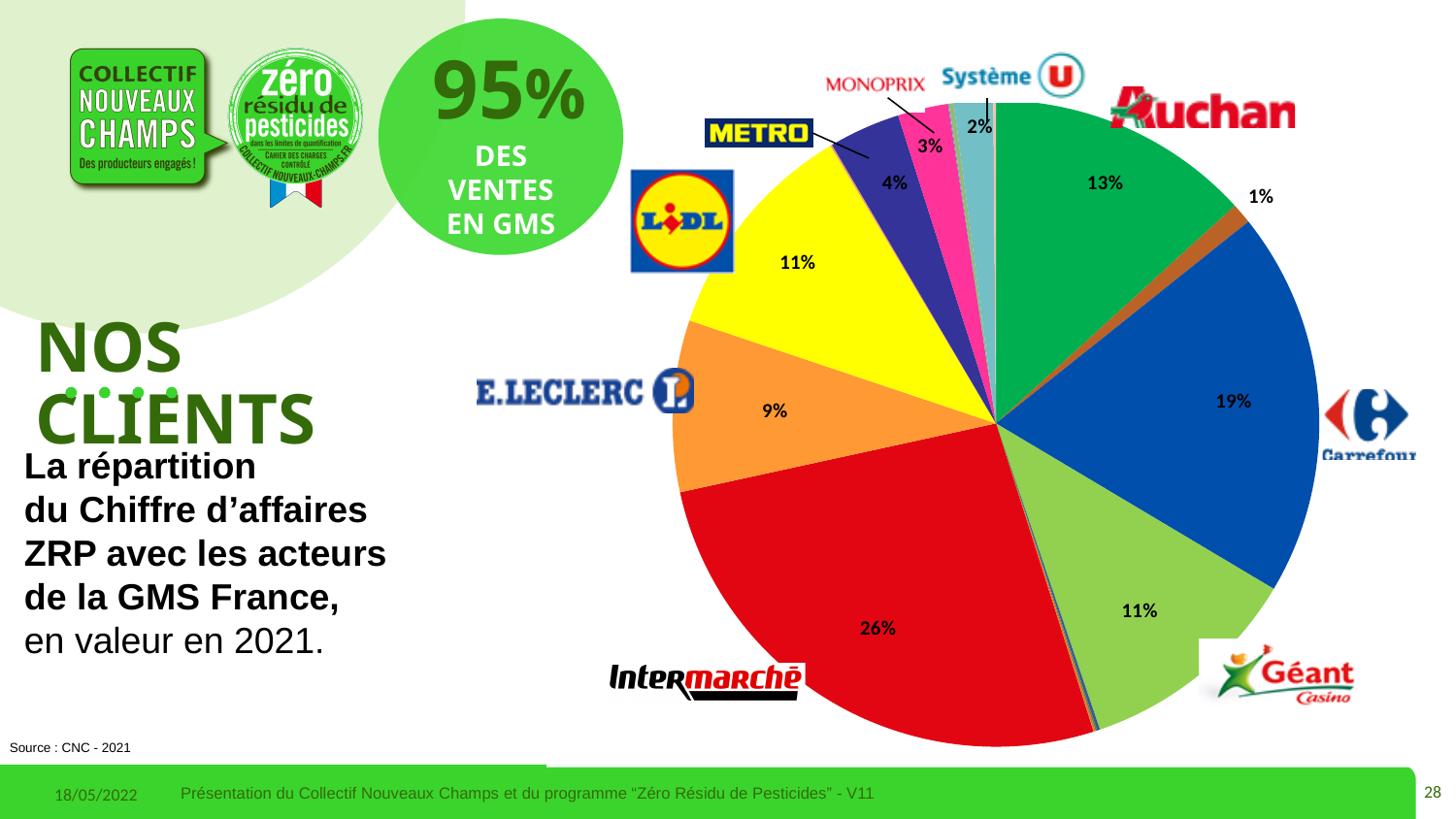
What percentage is shown for E.Leclerc? 9% What percentage is shown for Auchan? 13% Which has a larger share, Auchan or E.Leclerc? Auchan What percentage is shown for Carrefour? 19% What type of chart is shown on the slide? pie chart What share of the pie does Intermarché hold? 26% What percentage is shown for Metro? 4% What is the difference in percentage points between Intermarché and Carrefour? 7 Which retailer has the largest slice of the pie? Intermarché What percentage is shown for Système U? 2% What percentage of sales in GMS is stated in the green circle next to the chart? 95% What percentage is shown for Monoprix? 3%